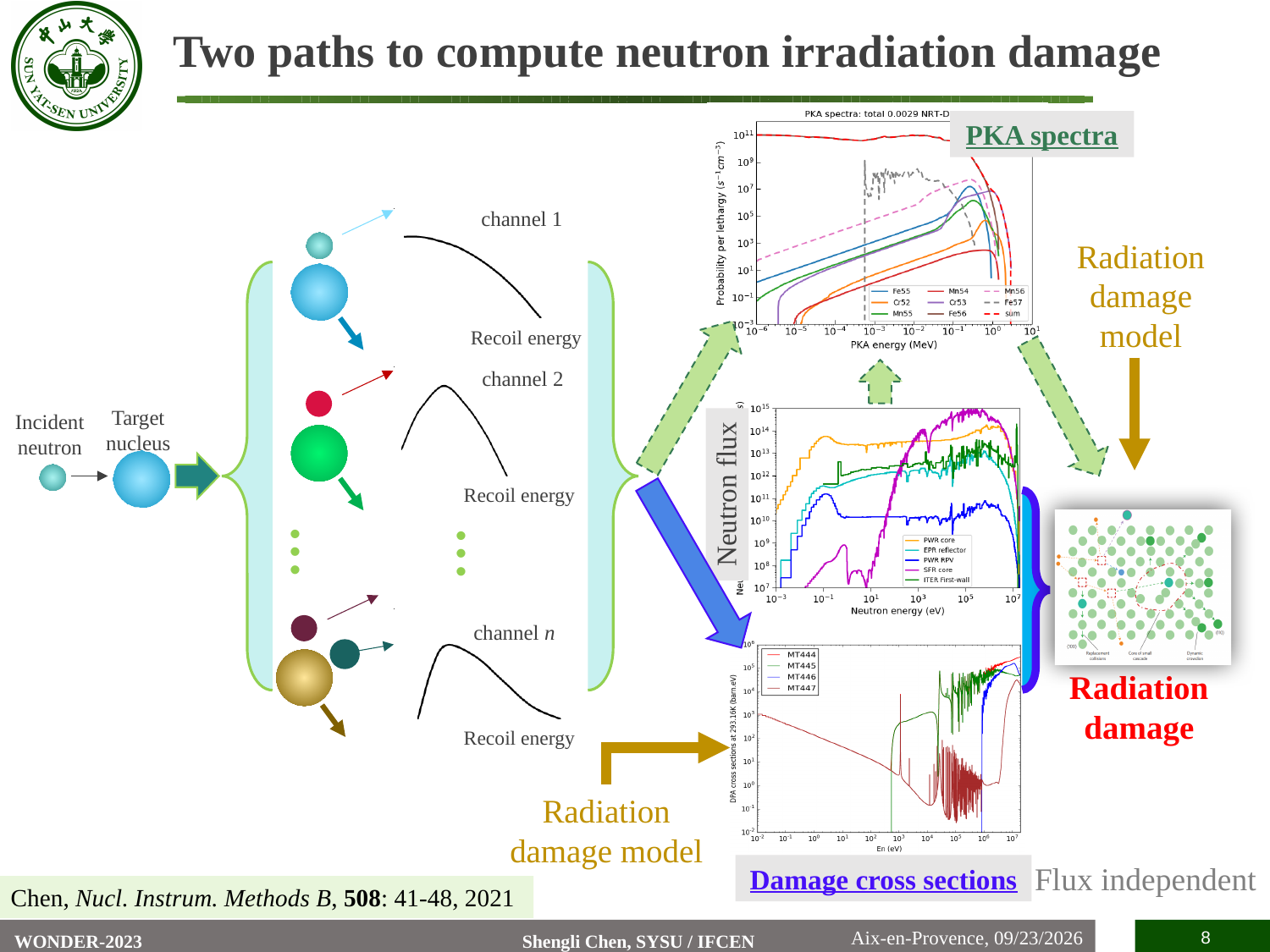
How many series does the legend of the Neutron flux chart list? 5 In the Neutron flux chart, which series reaches the highest flux value? SFR core How many series does the legend of the PKA spectra chart list? 9 In the Damage cross sections chart, does the MT444 curve rise or fall as the energy increases from 10^-2 eV to 10^2 eV? fall What is the x-axis label of the Neutron flux chart? Neutron energy (eV) In the Neutron flux chart, is the PWR RPV value at a neutron energy of 10^3 eV greater or less than 10^11? less In the Neutron flux chart, is the PWR core value at a neutron energy of 10^-1 eV greater or less than 10^13? greater How many charts are shown on the slide? 3 What is the x-axis label of the PKA spectra chart? PKA energy (MeV) How many series does the legend of the Damage cross sections chart list? 4 What kind of chart is the PKA spectra chart in the top right? line chart What kind of chart is the Damage cross sections chart? line chart